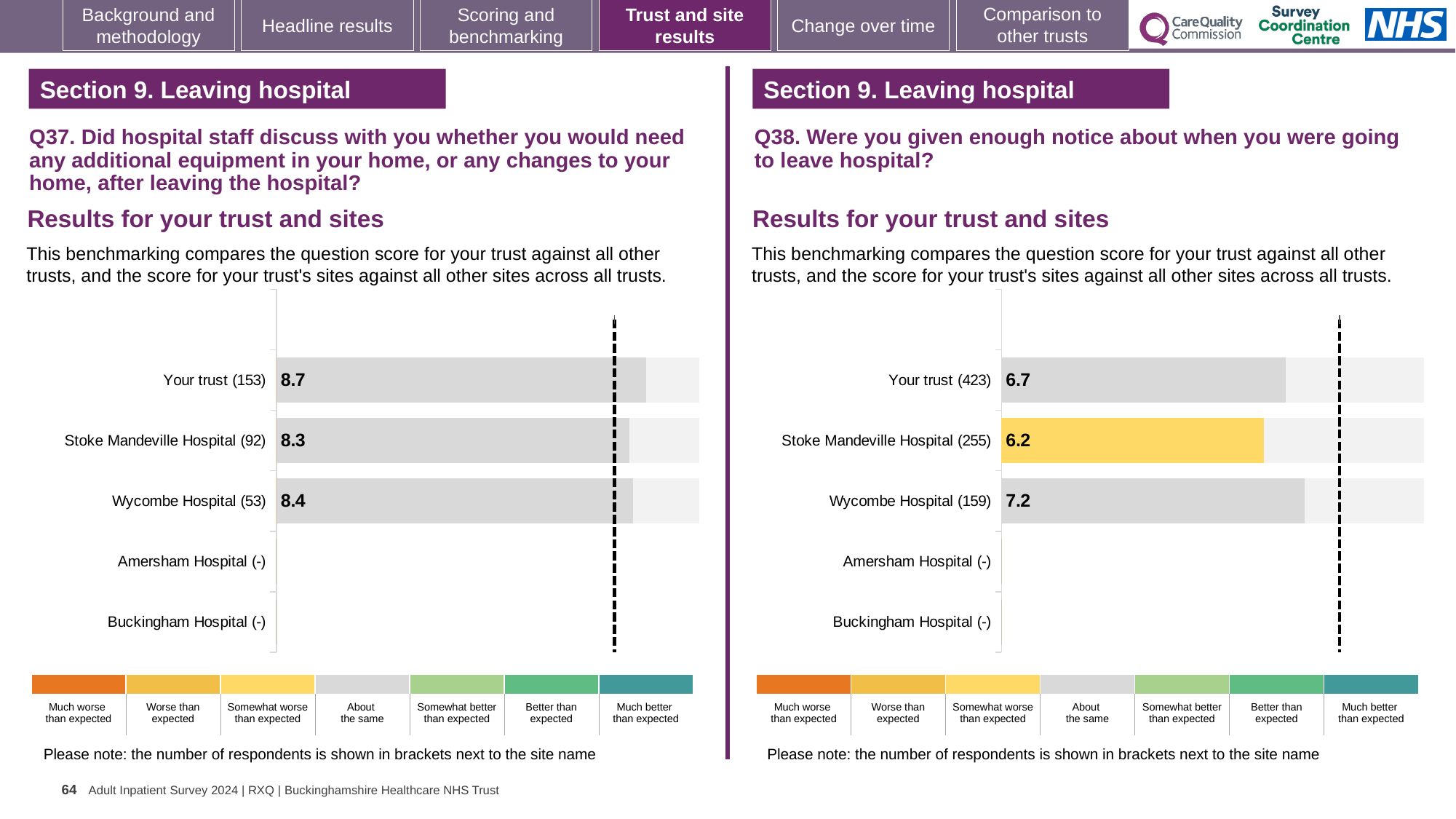
In the Q37 chart on the left, what is the score for Stoke Mandeville Hospital? 8.3 In the Q38 chart on the right, which site's bar is coloured yellow (somewhat worse than expected)? Stoke Mandeville Hospital What kind of chart is used on this slide to show the trust and site scores? Bar chart In the Q37 chart on the left, how many respondents are shown in brackets for Your trust? 153 In the Q38 chart on the right, what is the score for Wycombe Hospital? 7.2 In the Q38 chart on the right, which site or trust row has the lowest score? Stoke Mandeville Hospital In the Q37 chart on the left, what is the score for Your trust? 8.7 In the Q37 chart on the left, which has the higher score: Wycombe Hospital or Stoke Mandeville Hospital? Wycombe Hospital In the Q38 chart on the right, what is the difference between the score for Wycombe Hospital and the score for Stoke Mandeville Hospital? 1.0 In the Q38 chart on the right, what is the score for Stoke Mandeville Hospital? 6.2 In the Q37 chart on the left, what is the difference between the score for Your trust and the score for Stoke Mandeville Hospital? 0.4 In the Q38 chart on the right, which site or trust row has the highest score? Wycombe Hospital